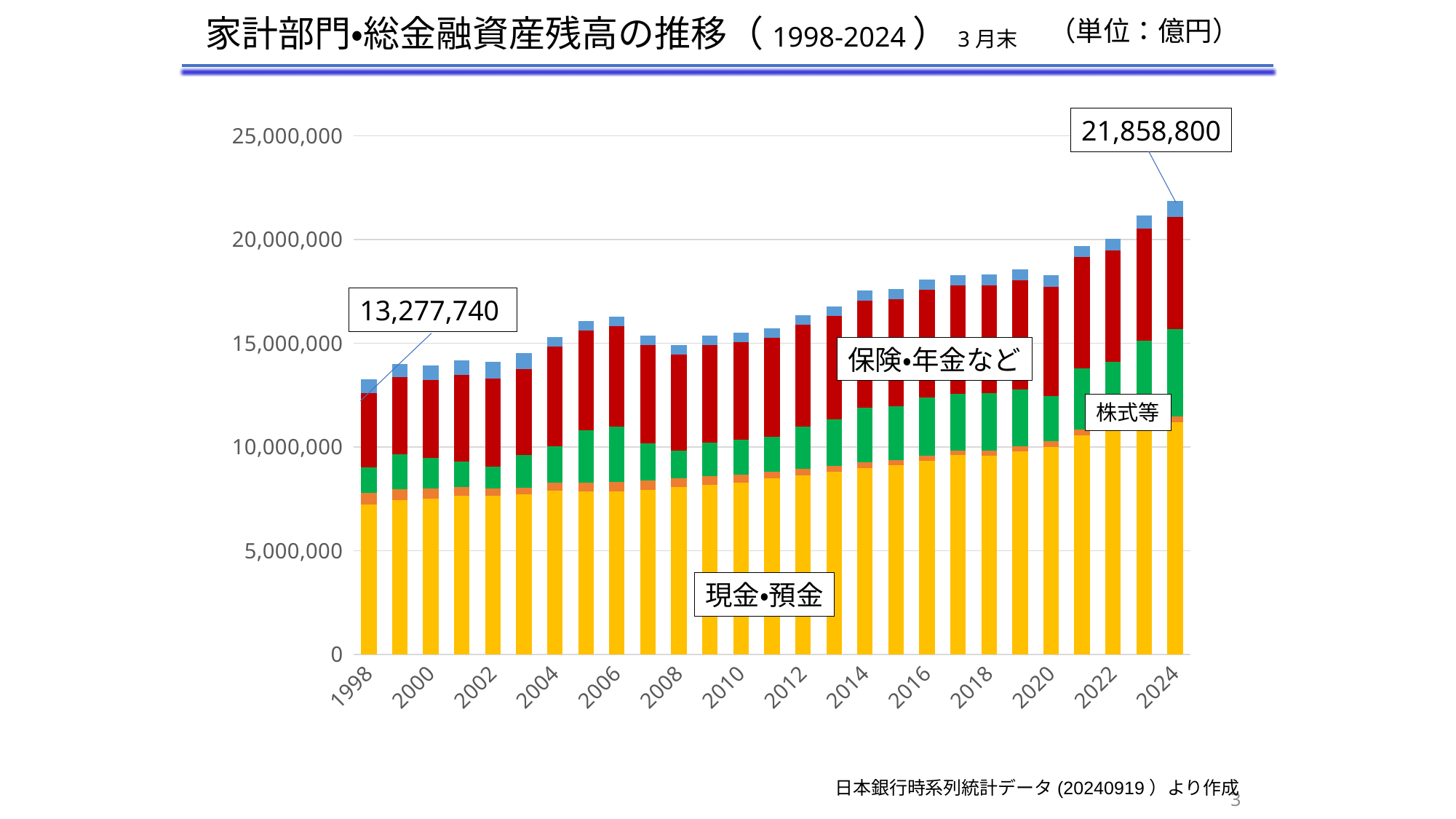
Is the total for 2024 greater or less than 20,000,000? greater Which year has the higher labelled total, 1998 or 2024? 2024 Which year has the lowest total bar? 1998 Is the total for 2020 greater or less than 15,000,000? greater What kind of chart is shown on the slide? stacked bar chart What is the total household financial asset balance labelled for 2024? 21,858,800 What is the difference between the labelled totals for 2024 and 1998? 8,581,060 Which year has the highest total bar? 2024 Which component is shown at the bottom of each stacked bar? 現金・預金 Do the total bars generally rise or fall from 1998 to 2024? rise What is the total household financial asset balance labelled for 1998? 13,277,740 How many years (bars) are plotted on the chart? 27